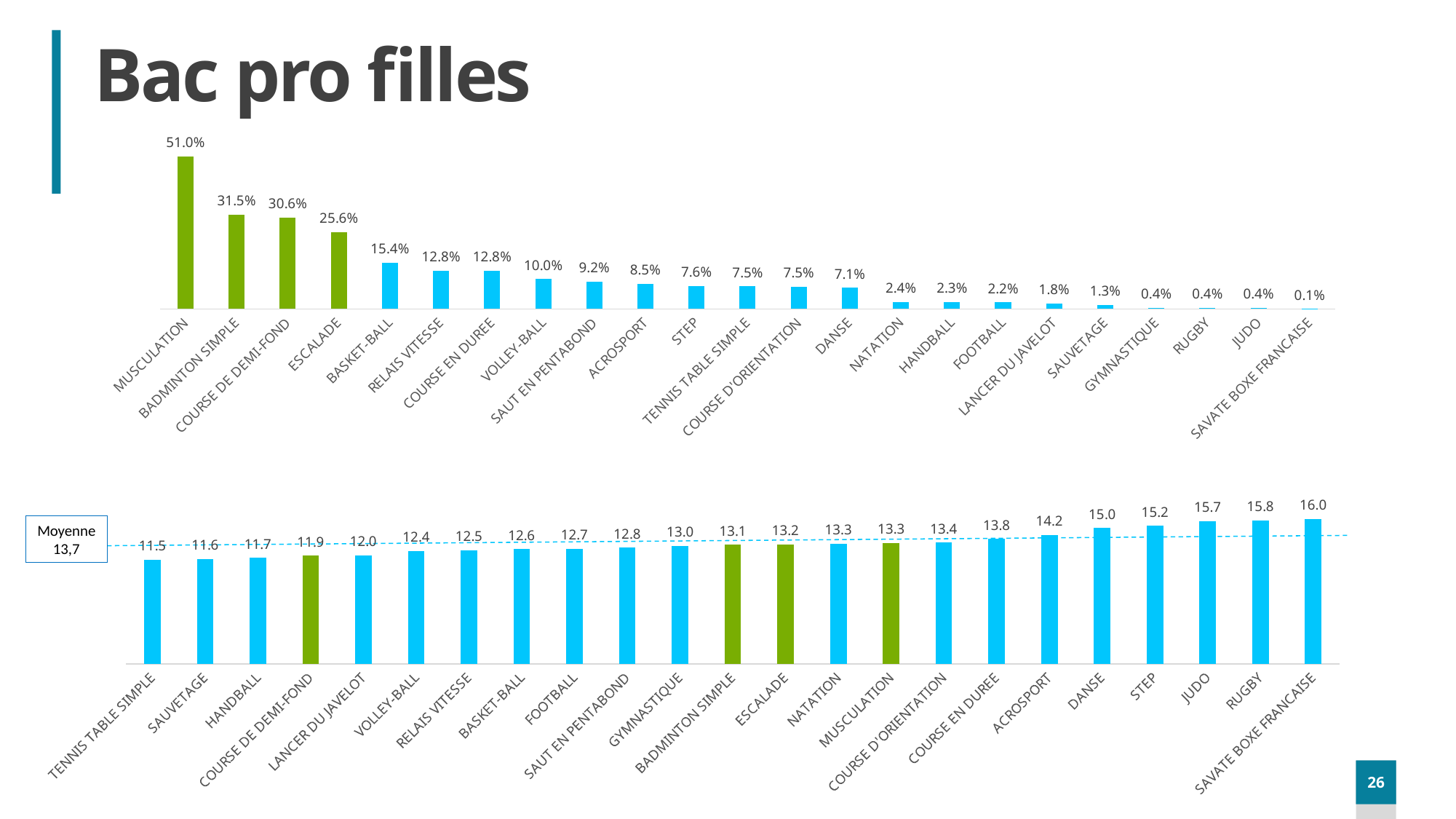
In the bottom chart, what is the value for SAVATE BOXE FRANCAISE? 16.0 In the top chart, how many categories are plotted? 23 In the top chart, what is the difference between BADMINTON SIMPLE and ESCALADE? 5.9% In the bottom chart, what is the value of the 'Moyenne' shown by the dashed line? 13,7 In the top chart, what is the value for MUSCULATION? 51.0% In the top chart, which category has the lowest value? SAVATE BOXE FRANCAISE What kind of chart is the top chart? Bar chart In the bottom chart, what is the difference between JUDO and DANSE? 0.7 In the bottom chart, which category has the lowest value? TENNIS TABLE SIMPLE In the top chart, which is larger, BASKET-BALL or VOLLEY-BALL? BASKET-BALL In the bottom chart, which is larger, ACROSPORT or COURSE EN DUREE? ACROSPORT In the bottom chart, do the values rise or fall from left to right? Rise